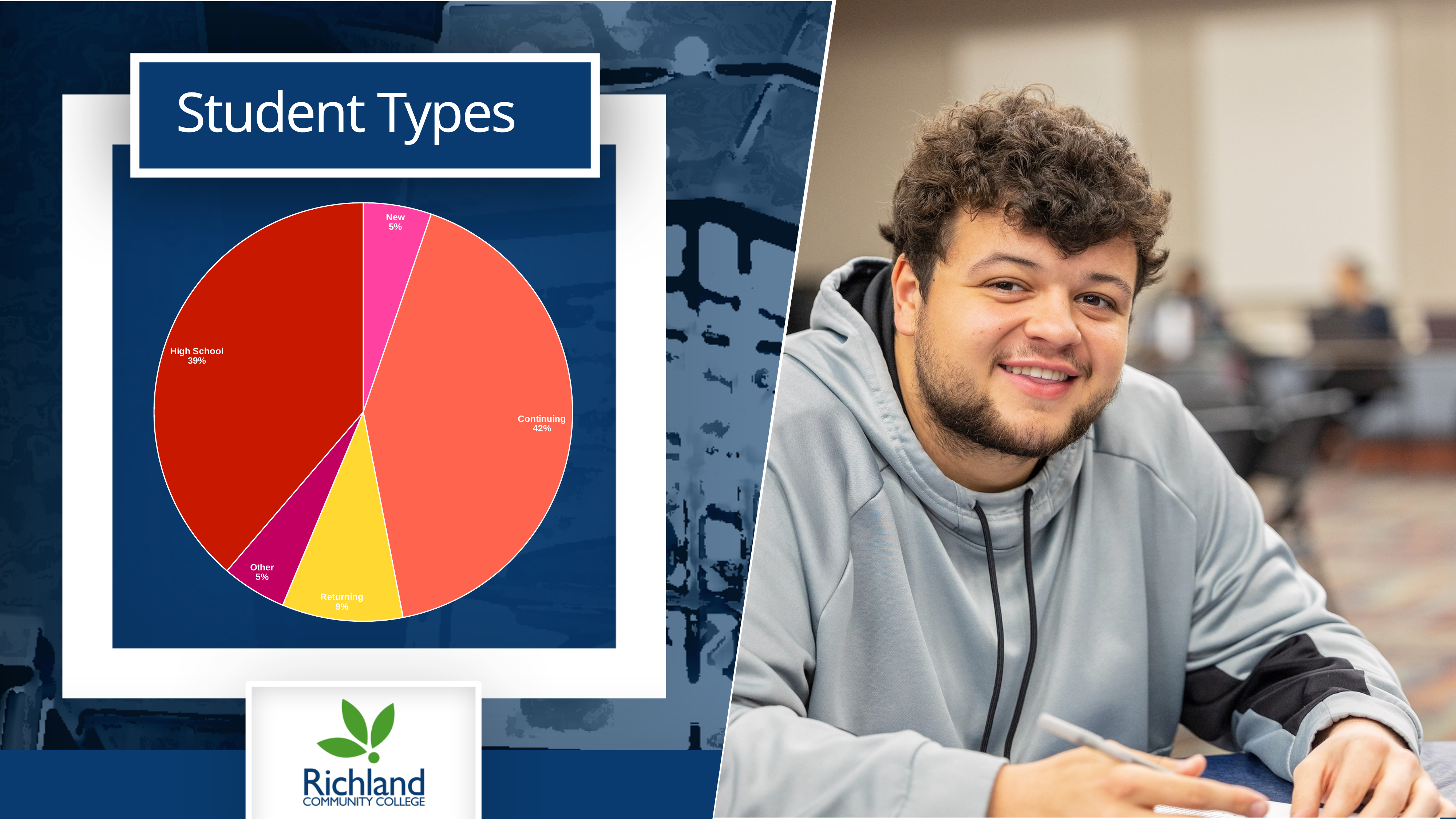
What percentage of students are Returning? 9% How many slices does the pie chart have? 5 What is the title of the chart? Student Types What is the combined share of Continuing and High School students? 81% What type of chart is shown on the slide? pie chart What is the difference in percentage points between Continuing and High School? 3 What percentage of students are New? 5% What colour is the High School slice? red What percentage of students are Continuing? 42% Which student type has the largest share of the pie? Continuing Which is larger, the Returning share or the Other share? Returning What percentage of students are High School? 39%